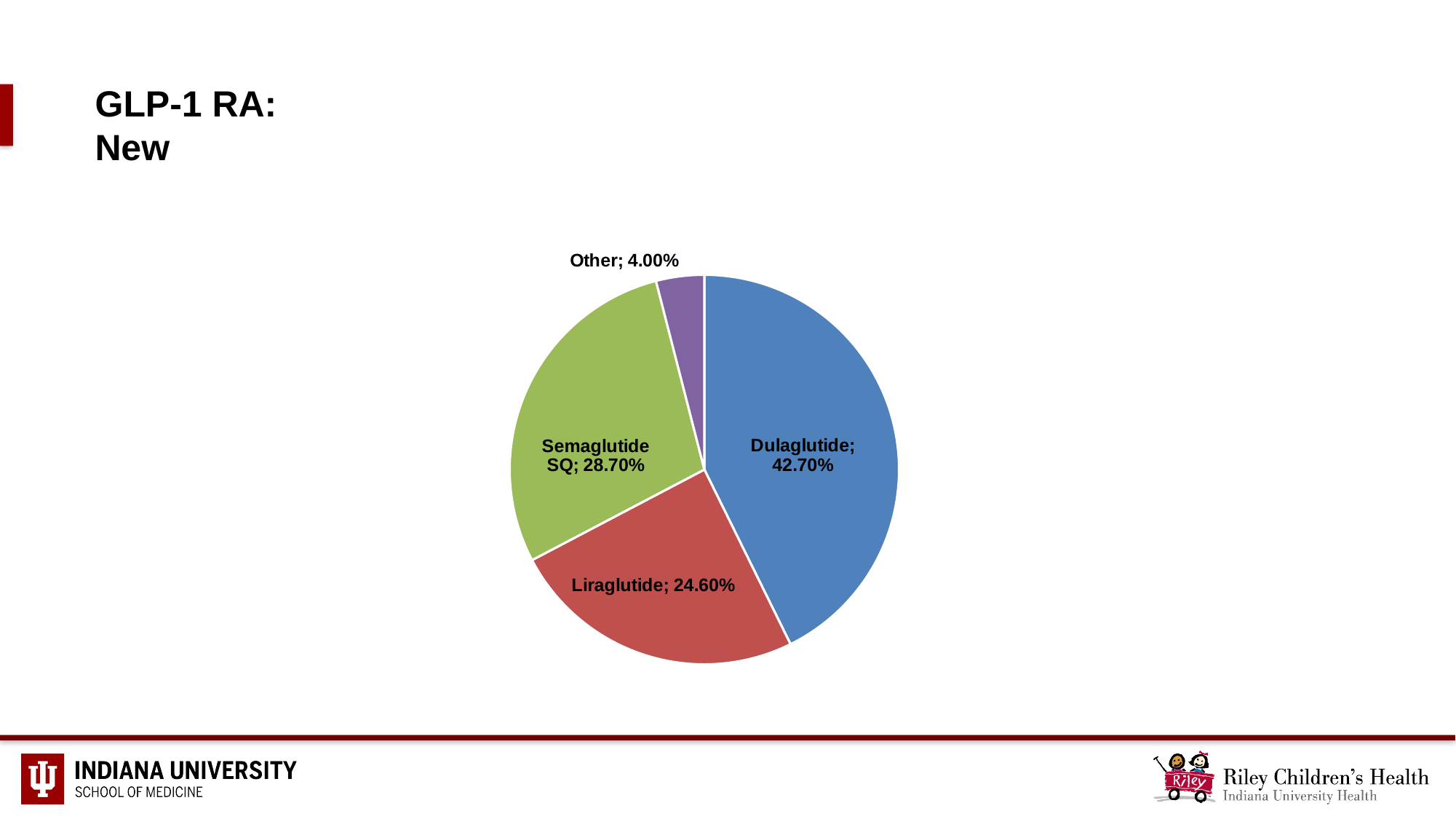
What is the difference between the Dulaglutide and Liraglutide values? 18.10% What type of chart is shown on the slide? pie chart How many slices does the pie chart have? 4 What is the value for Dulaglutide? 42.70% Which is larger, Semaglutide SQ or Liraglutide? Semaglutide SQ Which category has the smallest share of the pie? Other What is the value for Liraglutide? 24.60% What colour is the Dulaglutide slice? blue What is the value for Semaglutide SQ? 28.70% Which category has the largest share of the pie? Dulaglutide What is the difference between the Semaglutide SQ and Other values? 24.70% What is the value for Other? 4.00%